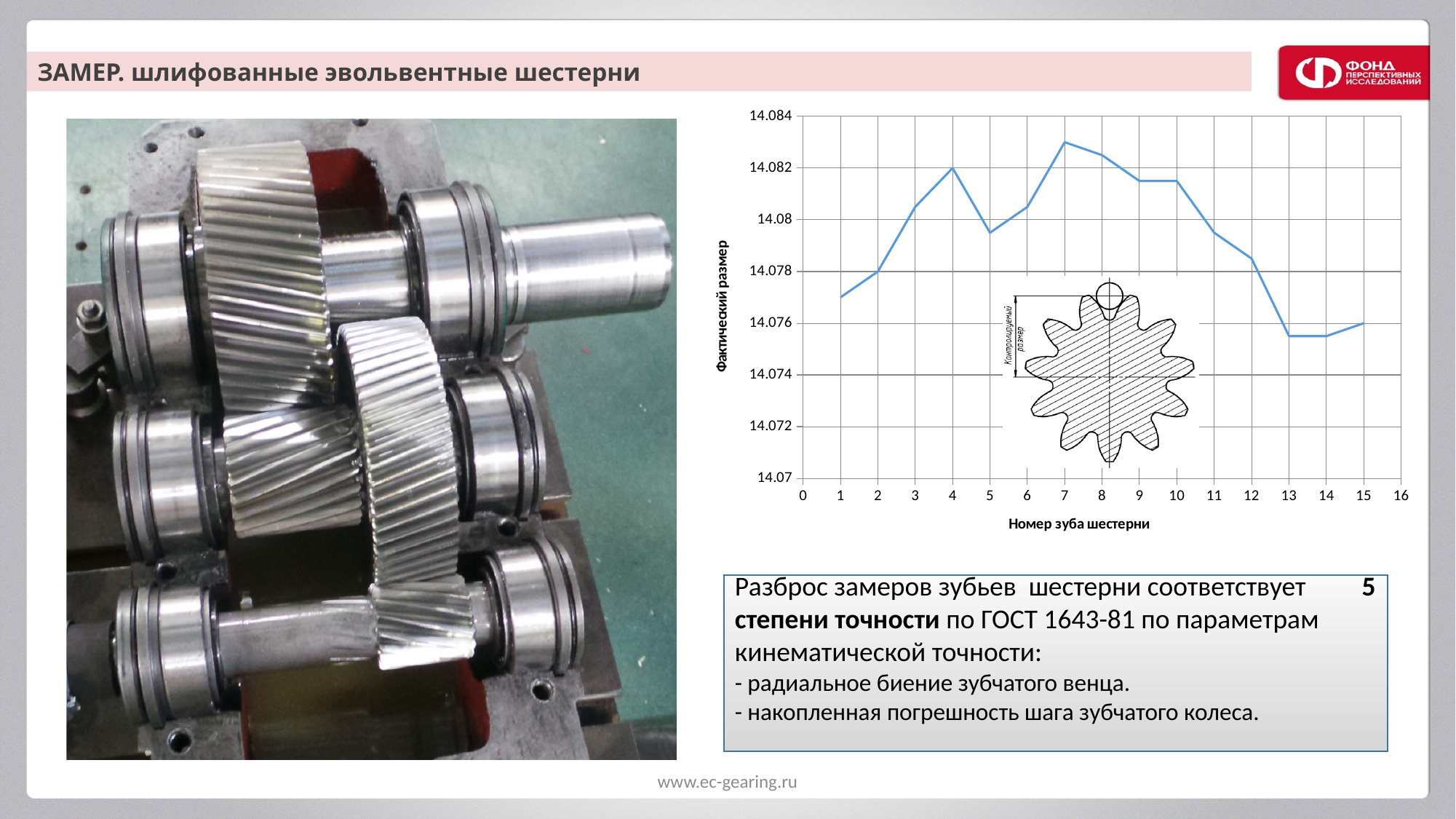
Which tooth number has the highest measured value? 7 What is the title of the x axis of the chart? Номер зуба шестерни Do the values rise or fall from tooth 7 to tooth 13? fall Is the value for tooth 1 greater or less than 14.078? less What kind of chart is shown on the slide? line chart Which has the larger value, tooth 7 or tooth 13? tooth 7 Which has the larger value, tooth 4 or tooth 5? tooth 4 Is the value for tooth 7 greater or less than 14.082? greater Is the value for tooth 10 greater or less than 14.08? greater How many data points (teeth) are plotted on the chart? 15 What is the title of the y axis of the chart? Фактический размер